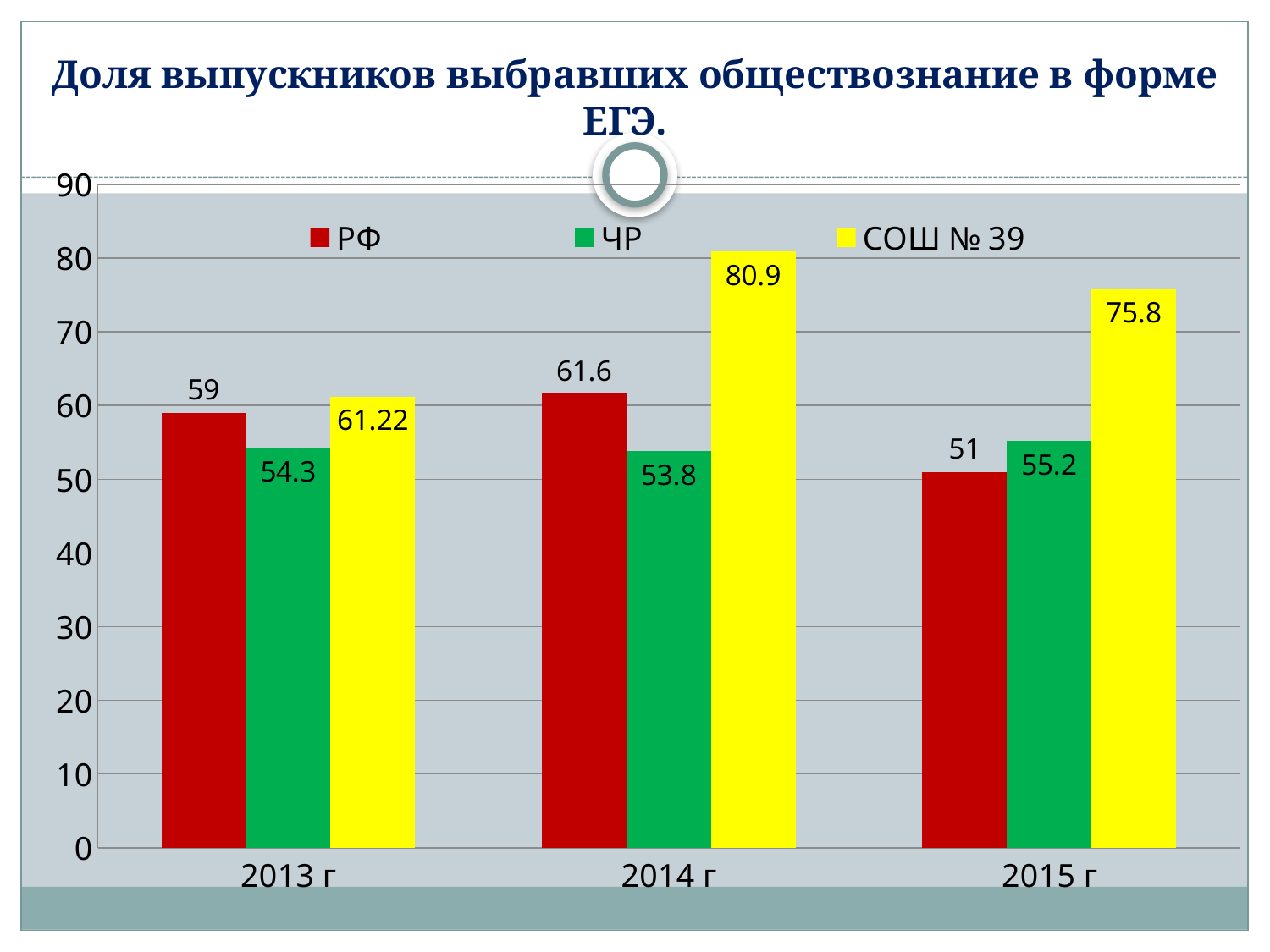
What is the value for РФ in 2013 г? 59 What is the difference between the СОШ № 39 value and the РФ value in 2014 г? 19.3 In which year is the value for СОШ № 39 highest? 2014 г How many series does the legend list? 3 Which colour represents СОШ № 39 in the legend? Yellow Is the value for СОШ № 39 in 2015 г greater or less than 70? greater Which is larger in 2013 г: the value for РФ or the value for ЧР? РФ In which year is the value for РФ lowest? 2015 г How many years are shown on the x axis? 3 What is the value for СОШ № 39 in 2014 г? 80.9 What kind of chart is shown on the slide? Bar chart What is the value for ЧР in 2015 г? 55.2